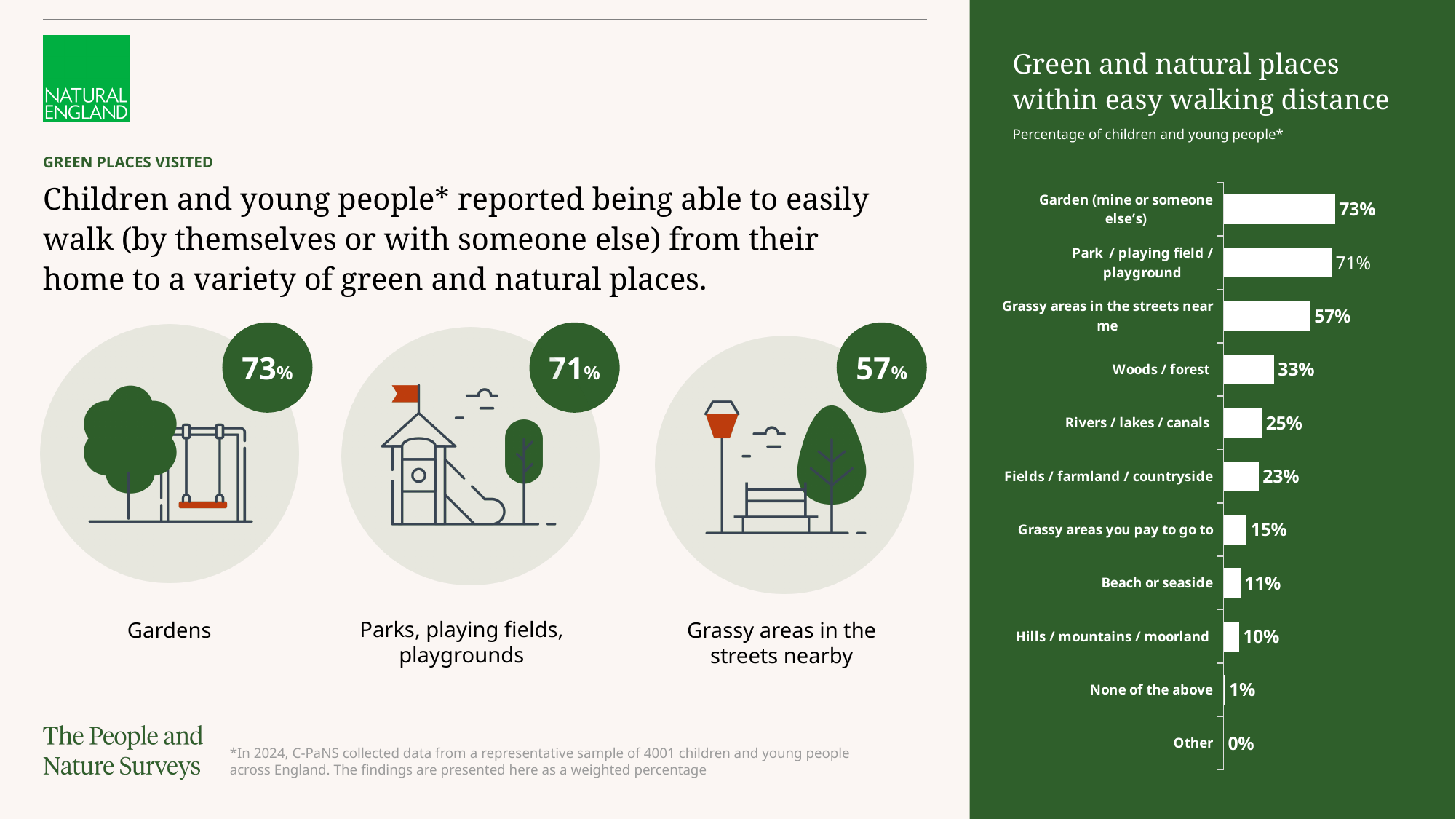
What is the difference between the percentages for Park / playing field / playground and Grassy areas in the streets near me? 14% Which is larger: the value for Rivers / lakes / canals or the value for Fields / farmland / countryside? Rivers / lakes / canals What kind of chart is shown on the slide? Bar chart What is the value for Woods / forest in the chart? 33% How many categories are shown in the chart? 11 Which category has the highest percentage in the chart? Garden (mine or someone else's) What is the title of the chart? Green and natural places within easy walking distance What is the value for Beach or seaside in the chart? 11% What is the difference between the percentages for Hills / mountains / moorland and None of the above? 9% What percentage of children and young people reported a garden (mine or someone else's) within easy walking distance? 73% What is the value for Grassy areas you pay to go to? 15% Which category has the lowest percentage in the chart? Other